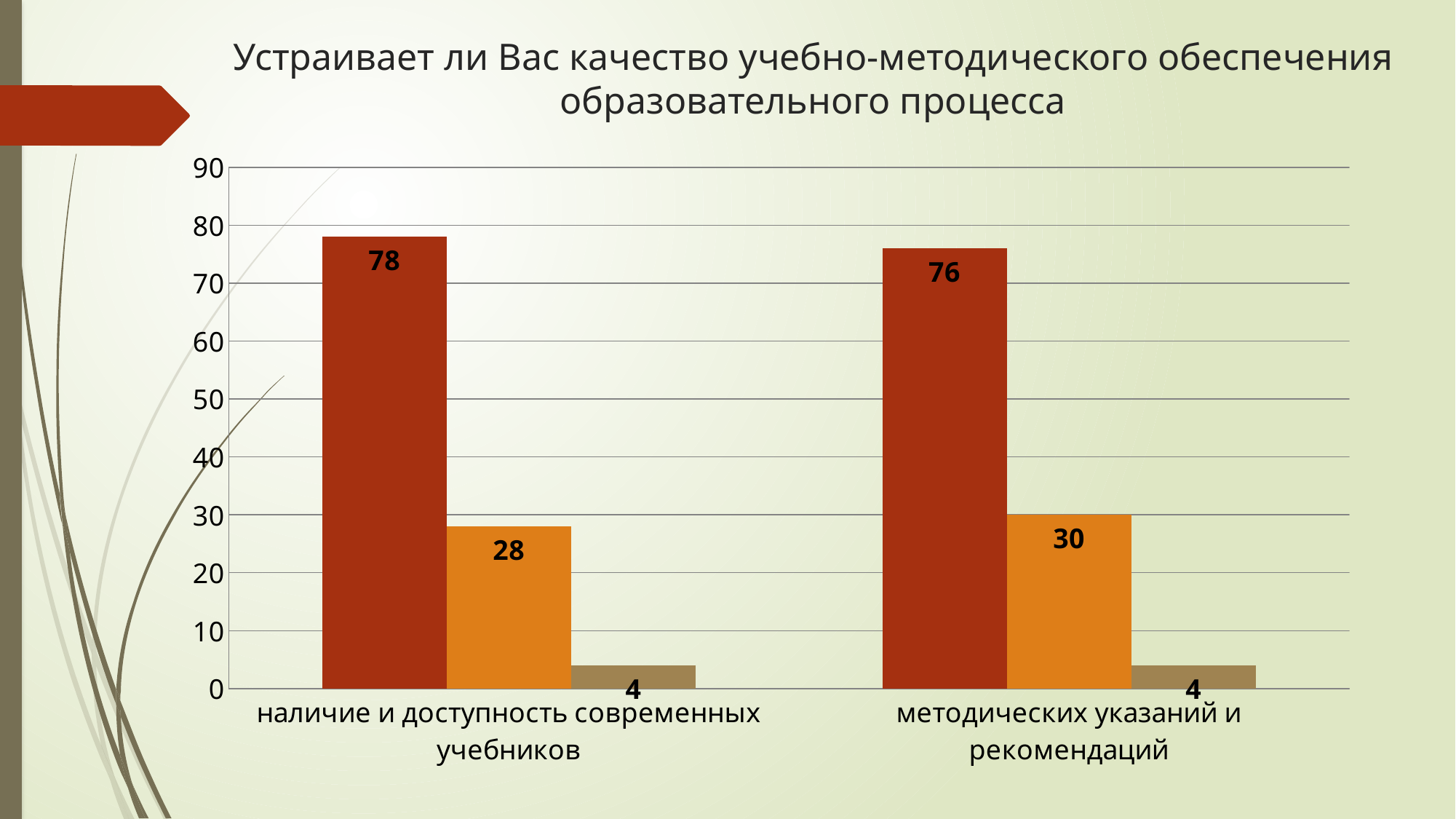
What is the title of the chart on the slide? Устраивает ли Вас качество учебно-методического обеспечения образовательного процесса How many bars are plotted for each category? 3 What type of chart is shown on the slide? bar chart What is the difference between the orange bars of the two categories? 2 What is the value of the dark red bar for "методических указаний и рекомендаций"? 76 Which is larger: the dark red bar for "наличие и доступность современных учебников" or the dark red bar for "методических указаний и рекомендаций"? наличие и доступность современных учебников How many categories are shown on the x axis of the chart? 2 What is the difference between the dark red bar and the orange bar for "наличие и доступность современных учебников"? 50 What is the value of the dark red bar for "наличие и доступность современных учебников"? 78 What is the value of the orange bar for "методических указаний и рекомендаций"? 30 What is the value of the tan bar for "наличие и доступность современных учебников"? 4 Which bar has the highest value in the chart? the dark red bar for "наличие и доступность современных учебников" (78)